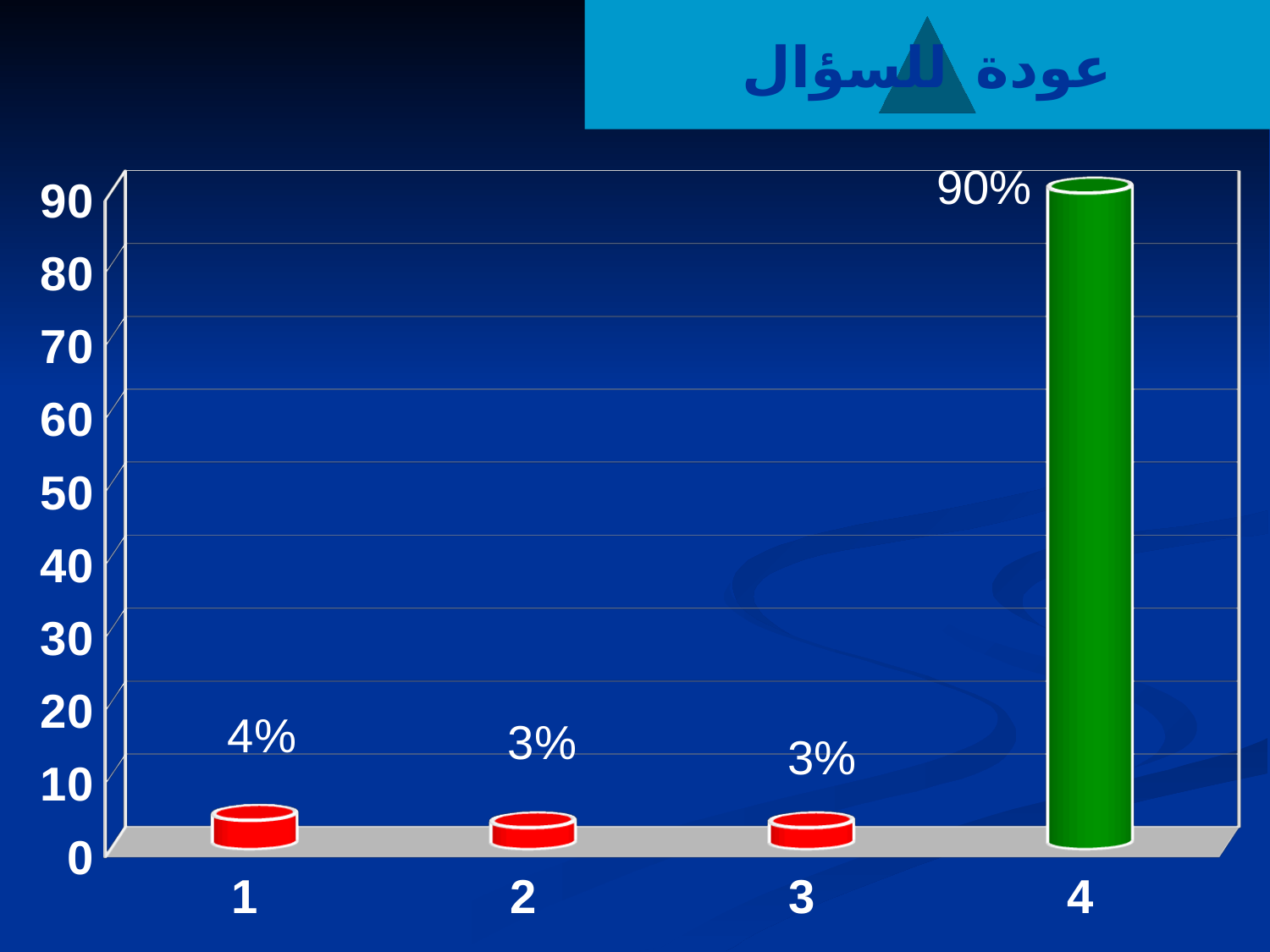
What is the value for category 2? 3% Which is larger, the value for category 1 or the value for category 3? Category 1 What colour is the bar for category 4? Green Is the value for category 4 greater or less than 80? greater Is the value for category 2 greater or less than 10? less What is the difference between the values for category 1 and category 2? 1% What is the value for category 4? 90% What is the difference between the values for category 4 and category 1? 86% Which category has the highest value? 4 What is the value for category 1? 4% What kind of chart is shown on the slide? Bar chart How many categories are shown on the x axis? 4